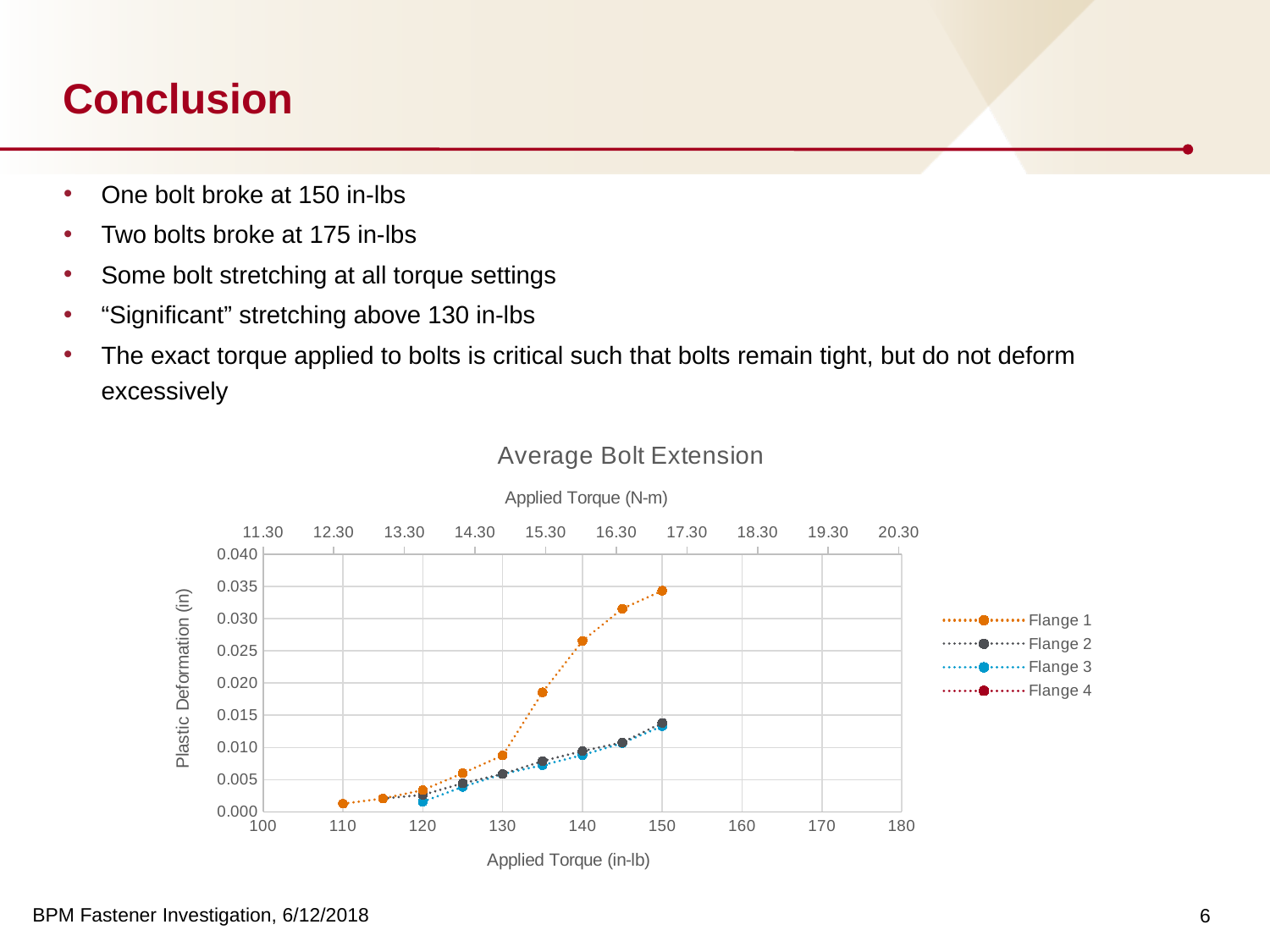
What is the title of the chart on the slide? Average Bolt Extension Is the plastic deformation for Flange 1 at 150 in-lb greater or less than 0.030? greater How many data points are plotted for Flange 1? 9 Is the plastic deformation for Flange 1 at 110 in-lb greater or less than 0.005? less At 140 in-lb applied torque, which has the larger plastic deformation, Flange 1 or Flange 3? Flange 1 How many series does the legend of the Average Bolt Extension chart list? 4 Is the plastic deformation for Flange 2 at 150 in-lb greater or less than 0.010? greater Does the plastic deformation for Flange 1 rise or fall as applied torque increases? rise What is the label of the vertical axis of the chart? Plastic Deformation (in) What kind of chart is shown on the slide? line chart Which series has the highest plastic deformation at 150 in-lb applied torque? Flange 1